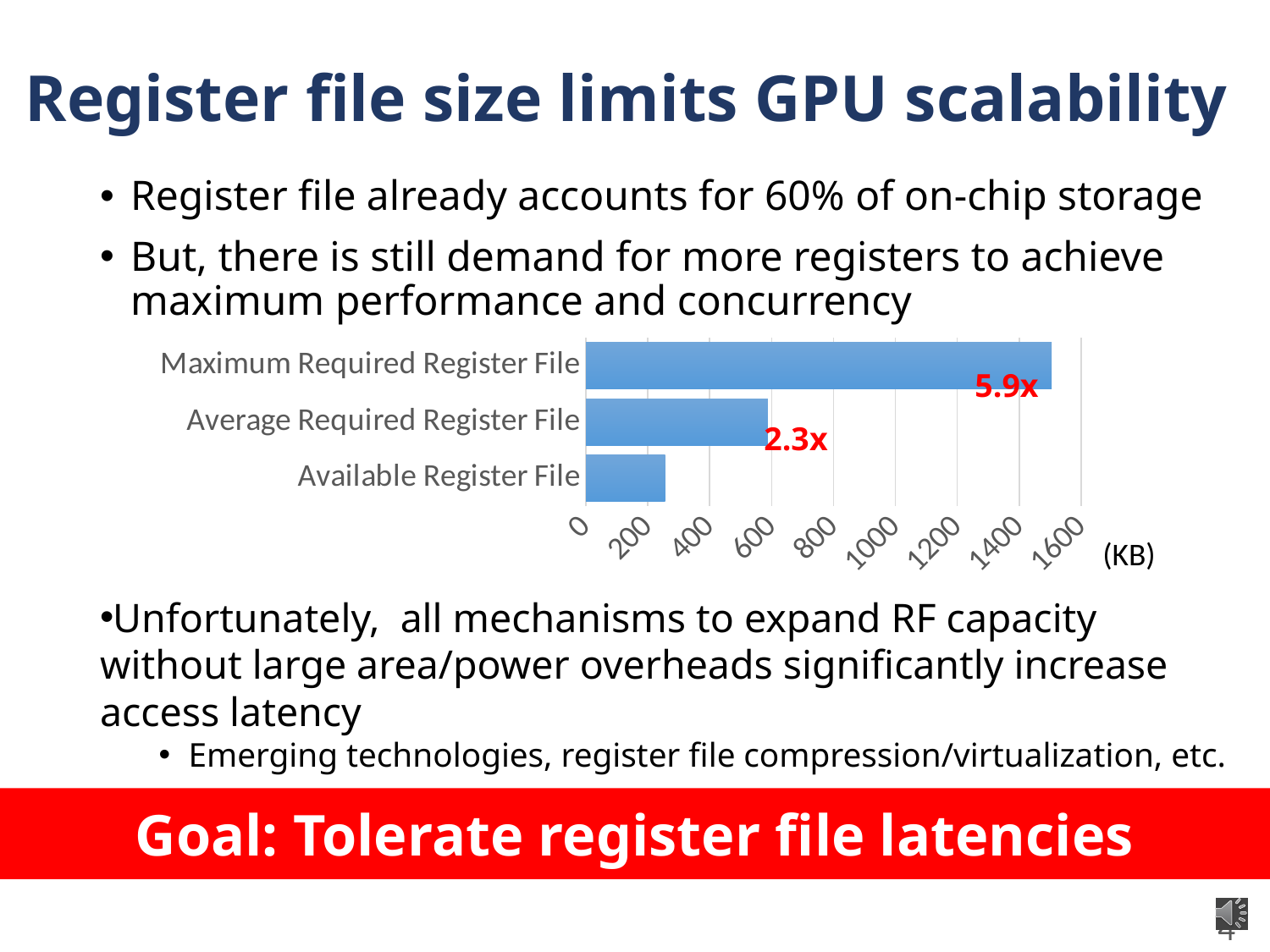
What multiplier label is printed on the Maximum Required Register File bar? 5.9x What unit is indicated for the chart's x axis? KB How many categories are plotted in the chart? 3 Is the value for Average Required Register File greater or less than 400? greater Which is larger, the Average Required Register File or the Available Register File? Average Required Register File What is the highest tick value shown on the chart's x axis? 1600 What kind of chart is shown on the slide? bar chart Is the value for Maximum Required Register File greater or less than 1400? greater Which category has the shortest bar in the chart? Available Register File Which category has the longest bar in the chart? Maximum Required Register File What multiplier label is printed on the Average Required Register File bar? 2.3x Is the value for Available Register File greater or less than 400? less